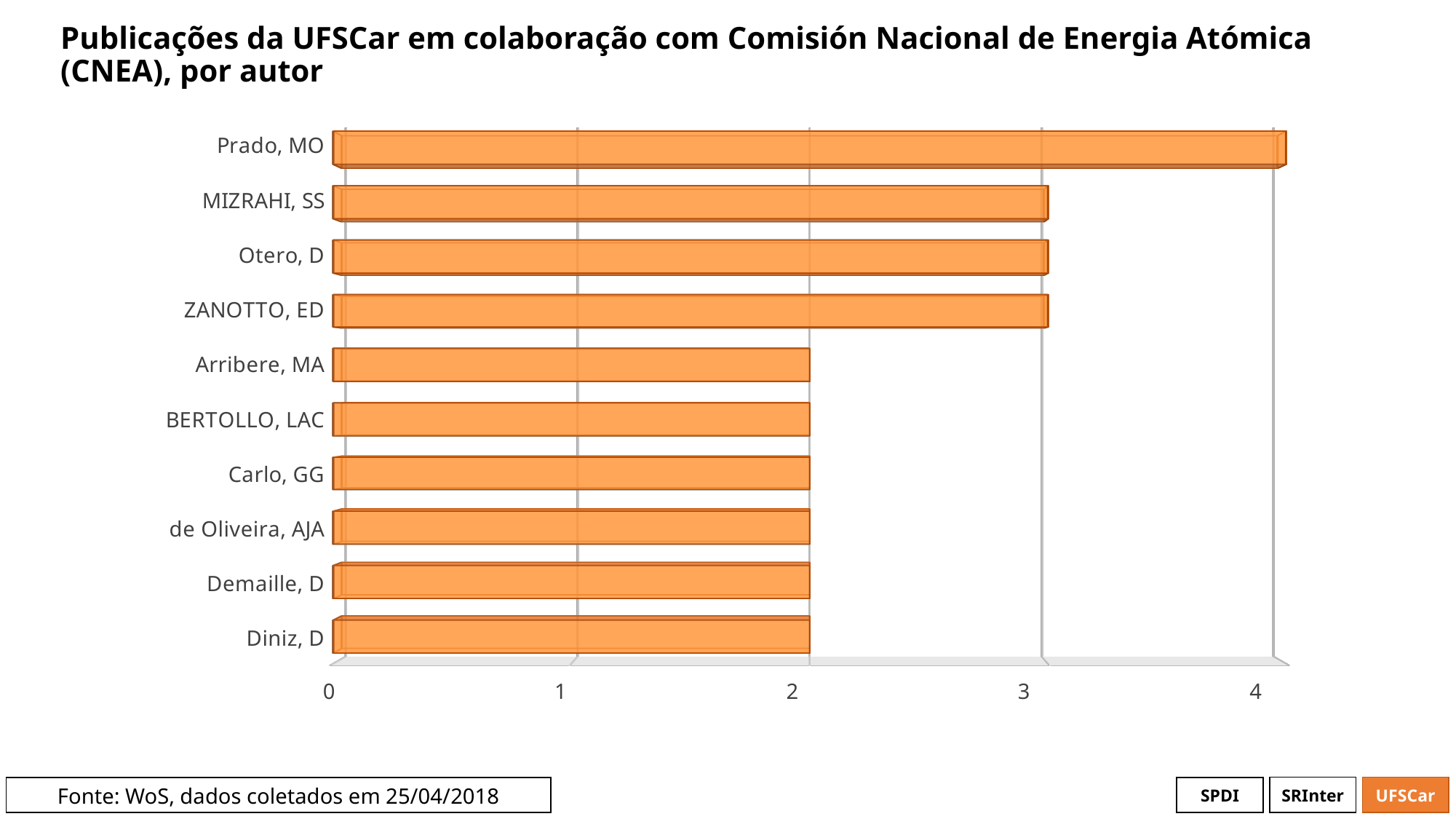
Which author has the highest number of publications? Prado, MO How many publications does ZANOTTO, ED have? 3 How many publications does Diniz, D have? 2 What is the difference in publications between Prado, MO and Diniz, D? 2 What kind of chart is shown on the slide? bar chart Is the value for Carlo, GG greater or less than 3? less Who has more publications, Prado, MO or Arribere, MA? Prado, MO How many authors are listed on the chart? 10 How many publications does MIZRAHI, SS have? 3 Is the value for Prado, MO greater or less than 3? greater How many publications does Prado, MO have? 4 What colour are the bars in the chart? orange